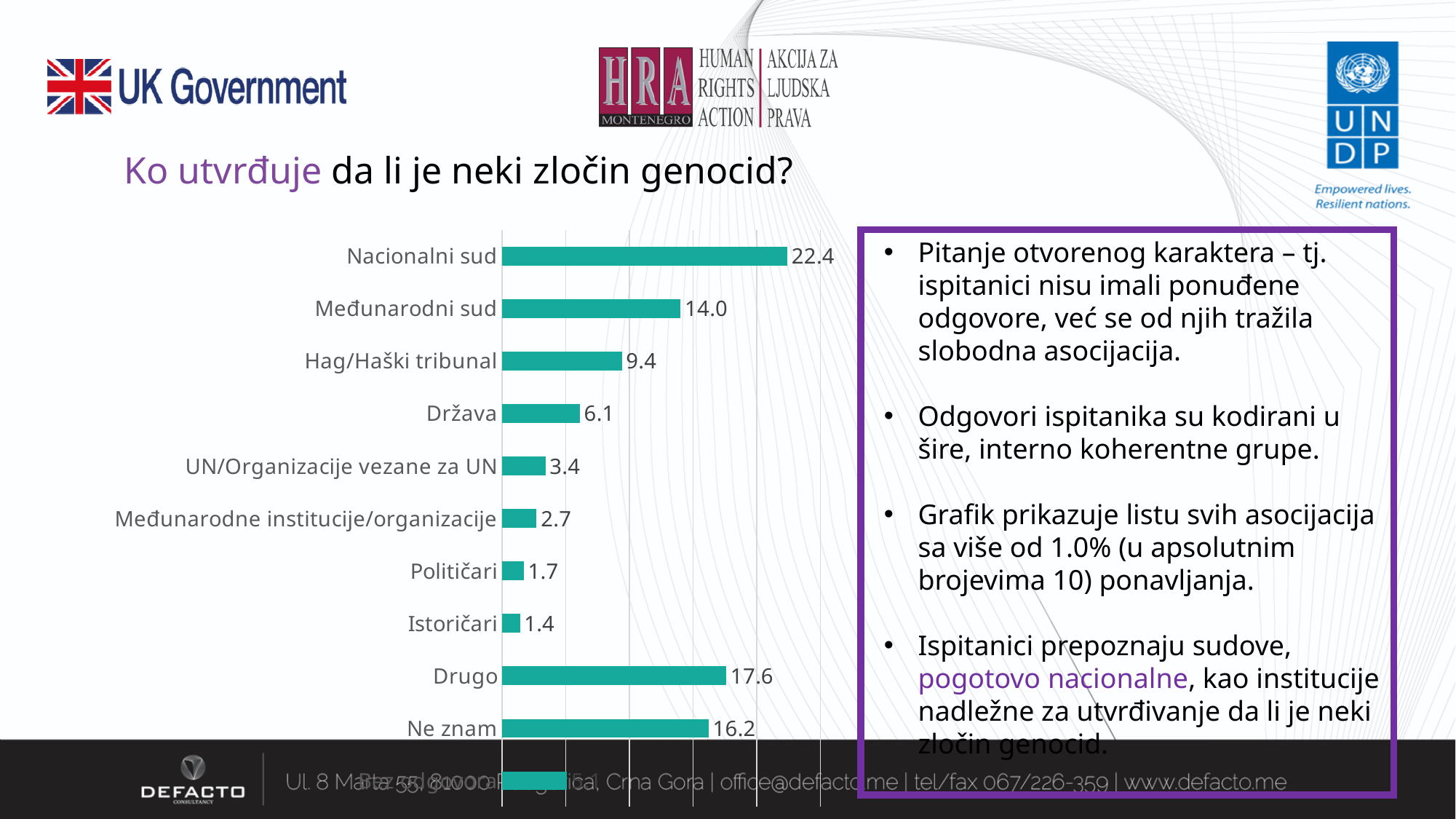
What is the value for Međunarodni sud? 14.0 Which is larger, the value for Drugo or the value for Ne znam? Drugo What colour are the bars in the chart? teal What type of chart is shown on the slide? bar chart What is the value for Političari? 1.7 What is the value for Nacionalni sud? 22.4 What is the difference between the values for Država and UN/Organizacije vezane za UN? 2.7 What is the difference between the values for Nacionalni sud and Međunarodni sud? 8.4 What is the value for Hag/Haški tribunal? 9.4 Which category has the highest value? Nacionalni sud What is the value for Ne znam? 16.2 Which category has the lowest value? Istoričari